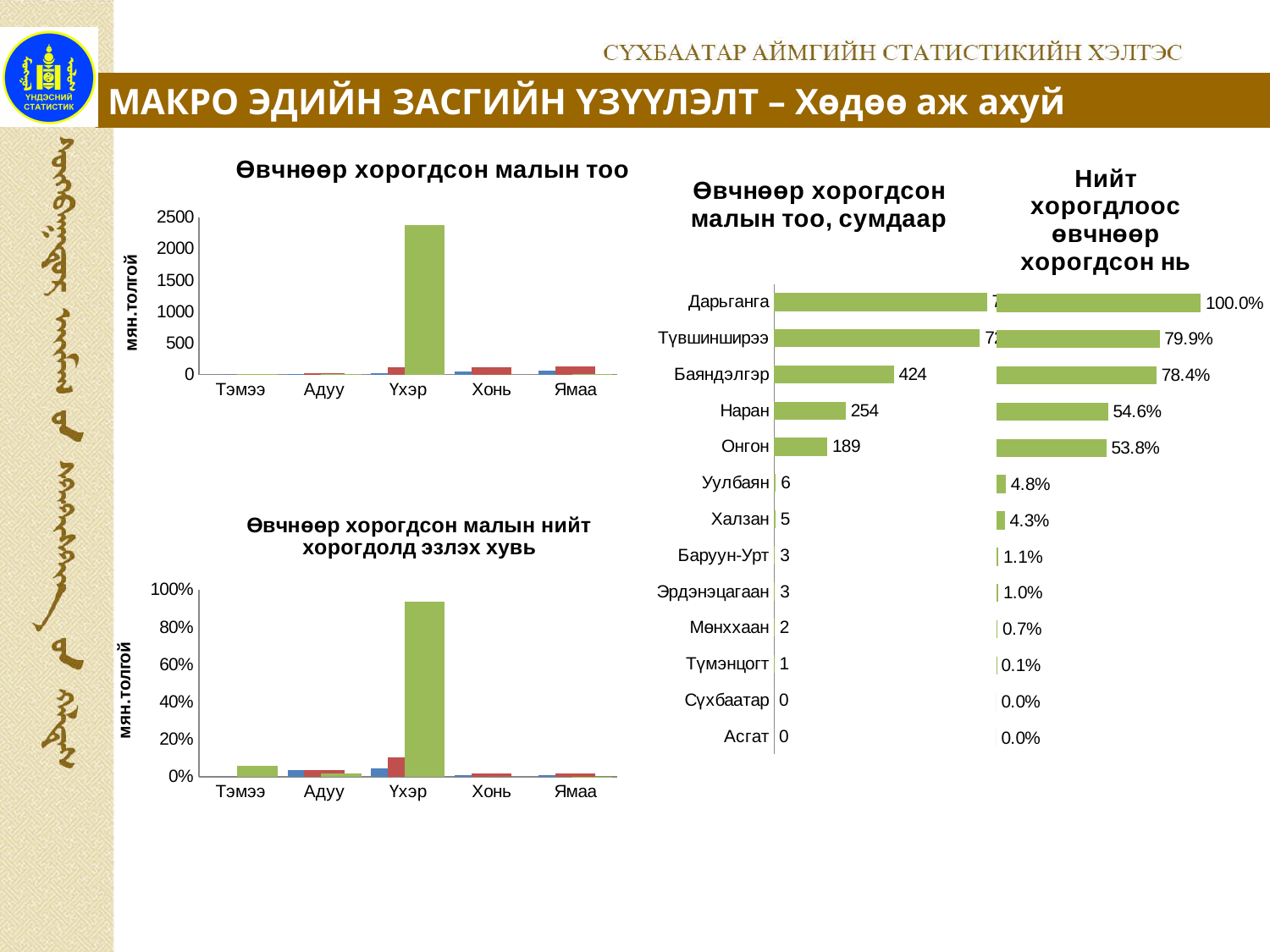
In the chart titled 'Өвчнөөр хорогдсон малын тоо, сумдаар', what is the value for Онгон? 189 In the chart titled 'Өвчнөөр хорогдсон малын тоо, сумдаар', what is the difference between the values for Баяндэлгэр and Наран? 170 What type of chart is the bottom-left chart titled 'Өвчнөөр хорогдсон малын нийт хорогдолд эзлэх хувь'? Bar chart In the top-left chart titled 'Өвчнөөр хорогдсон малын тоо', which livestock type has the highest bar? Үхэр In the chart titled 'Өвчнөөр хорогдсон малын тоо, сумдаар', which is larger, the value for Уулбаян or the value for Халзан? Уулбаян In the top-left chart titled 'Өвчнөөр хорогдсон малын тоо', is the tallest bar for Үхэр greater or less than 2000? greater How many sums are listed in the chart titled 'Өвчнөөр хорогдсон малын тоо, сумдаар'? 13 In the chart titled 'Өвчнөөр хорогдсон малын тоо, сумдаар', what is the value for Баяндэлгэр? 424